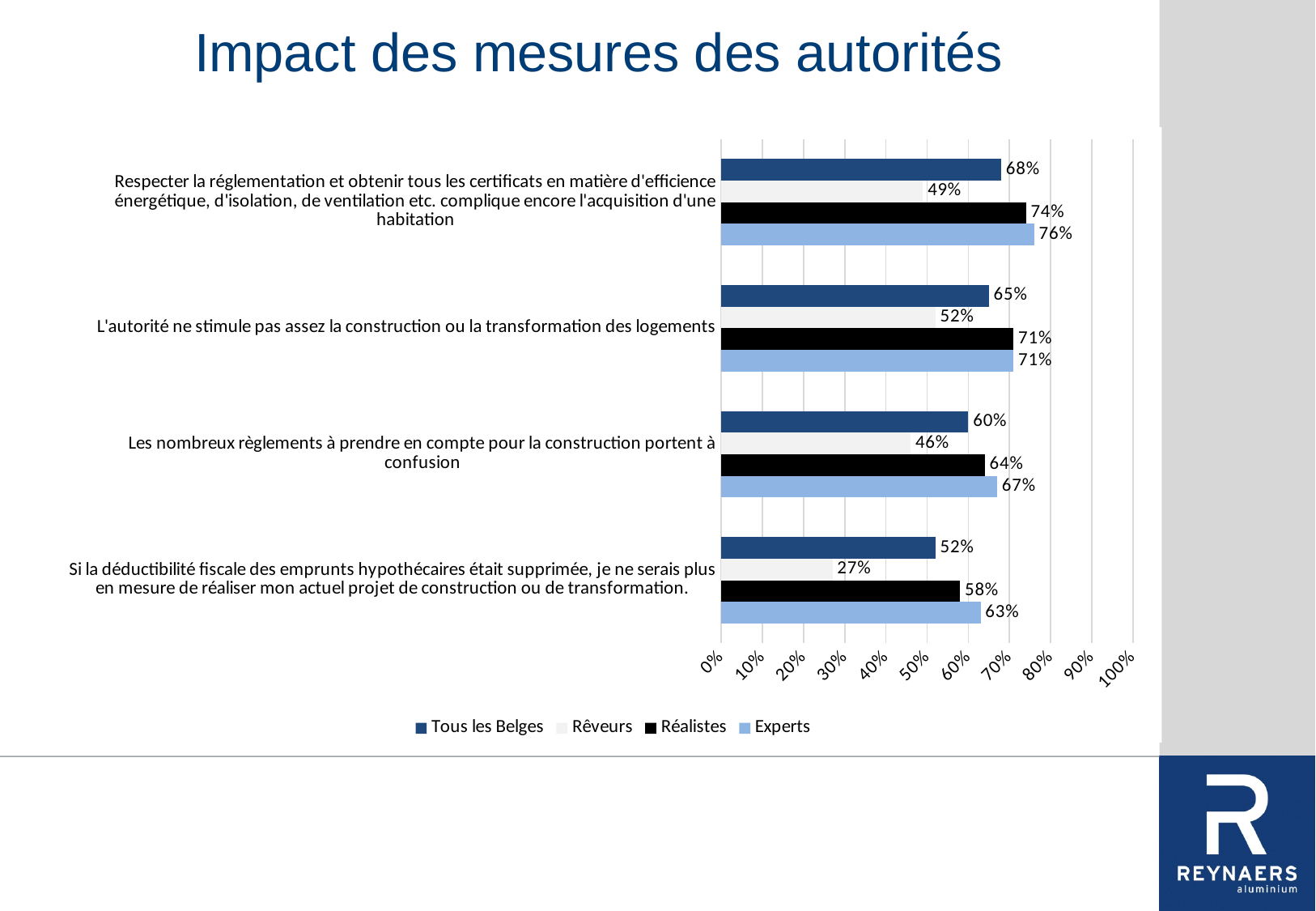
What is the value for Tous les Belges on the statement "Les nombreux règlements à prendre en compte pour la construction portent à confusion"? 60% How many statements (categories) are shown in the chart? 4 How many series does the legend list? 4 Which series has the highest value on the statement about respecting regulations and obtaining energy-efficiency certificates complicating the acquisition of a home? Experts What is the difference between the Experts value and the Rêveurs value on the statement about the suppression of the tax deductibility of mortgage loans? 36 percentage points What is the value for Experts on the statement "L'autorité ne stimule pas assez la construction ou la transformation des logements"? 71% Which series has the lowest value on the statement "Les nombreux règlements à prendre en compte pour la construction portent à confusion"? Rêveurs Which is larger on the statement "L'autorité ne stimule pas assez la construction ou la transformation des logements": the value for Tous les Belges or the value for Rêveurs? Tous les Belges Which series is shown in black in the chart? Réalistes What kind of chart is shown on the slide? Bar chart What is the title of the slide? Impact des mesures des autorités What is the value for Rêveurs on the statement "Si la déductibilité fiscale des emprunts hypothécaires était supprimée, je ne serais plus en mesure de réaliser mon actuel projet de construction ou de transformation."? 27%